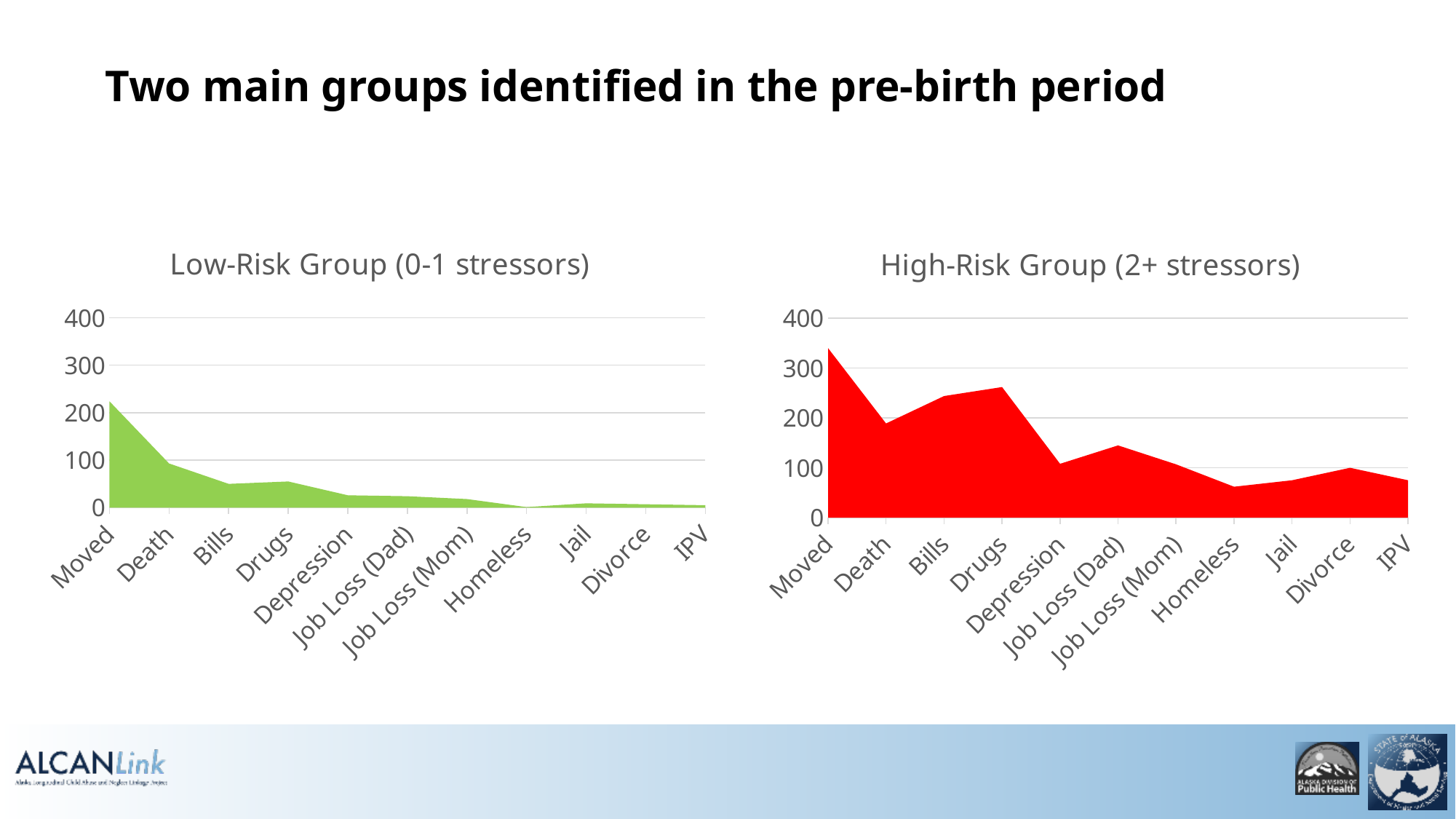
In the High-Risk Group (2+ stressors) chart, is the value for Moved greater or less than 300? greater In the High-Risk Group (2+ stressors) chart, which is larger, the value for Drugs or the value for Death? Drugs In the Low-Risk Group (0-1 stressors) chart, is the value for Moved greater or less than 200? greater What colour is the filled area in the High-Risk Group (2+ stressors) chart? Red In the High-Risk Group (2+ stressors) chart, is the value for Drugs greater or less than 200? greater What kind of chart is the Low-Risk Group (0-1 stressors) chart? Area chart Which chart shows the larger value for Moved, the Low-Risk Group chart or the High-Risk Group chart? High-Risk Group (2+ stressors) In the High-Risk Group (2+ stressors) chart, which stressor has the highest value? Moved How many stressor categories are shown on the x axis of the High-Risk Group (2+ stressors) chart? 11 In the Low-Risk Group (0-1 stressors) chart, which stressor has the highest value? Moved